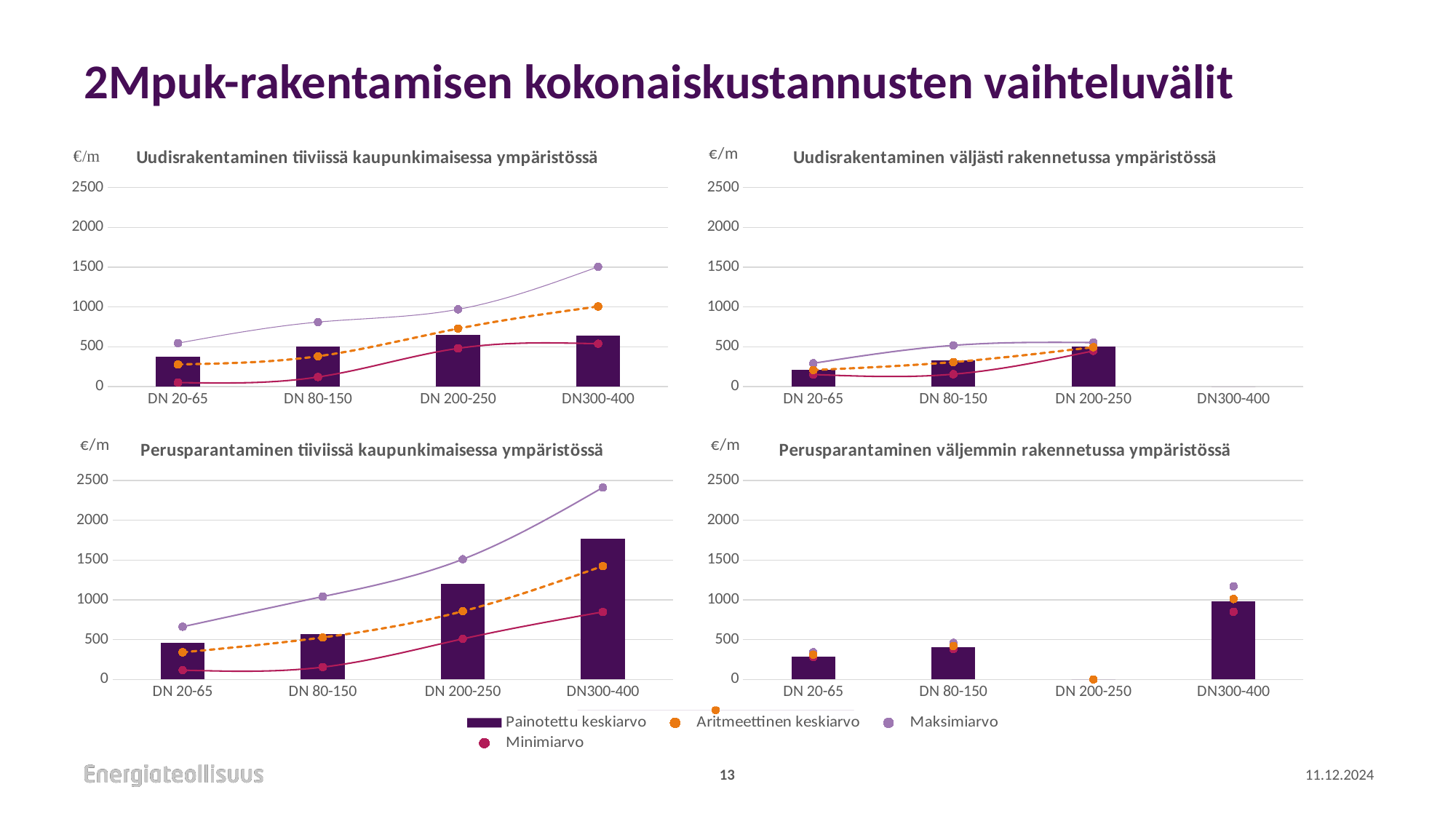
In the chart titled "Perusparantaminen tiiviissä kaupunkimaisessa ympäristössä", is the Maksimiarvo value for DN300-400 greater or less than 2000? greater In the chart titled "Uudisrakentaminen tiiviissä kaupunkimaisessa ympäristössä", which is larger, the Painotettu keskiarvo bar for DN 20-65 or for DN 200-250? DN 200-250 In the chart titled "Perusparantaminen tiiviissä kaupunkimaisessa ympäristössä", which category has the highest Painotettu keskiarvo bar? DN300-400 In the chart titled "Perusparantaminen väljemmin rakennetussa ympäristössä", is the Maksimiarvo value for DN300-400 greater or less than 1000? greater How many series does the shared legend at the bottom of the slide list? 4 In the chart titled "Perusparantaminen tiiviissä kaupunkimaisessa ympäristössä", does the Maksimiarvo series rise or fall from DN 20-65 to DN300-400? rise What unit is shown on the y axis of the chart titled "Uudisrakentaminen tiiviissä kaupunkimaisessa ympäristössä"? €/m How many categories are shown on the x axis of the chart titled "Uudisrakentaminen tiiviissä kaupunkimaisessa ympäristössä"? 4 In the chart titled "Perusparantaminen väljemmin rakennetussa ympäristössä", which category has the highest Painotettu keskiarvo bar? DN300-400 In the chart titled "Uudisrakentaminen väljästi rakennetussa ympäristössä", is the Painotettu keskiarvo value for DN 20-65 greater or less than 500? less